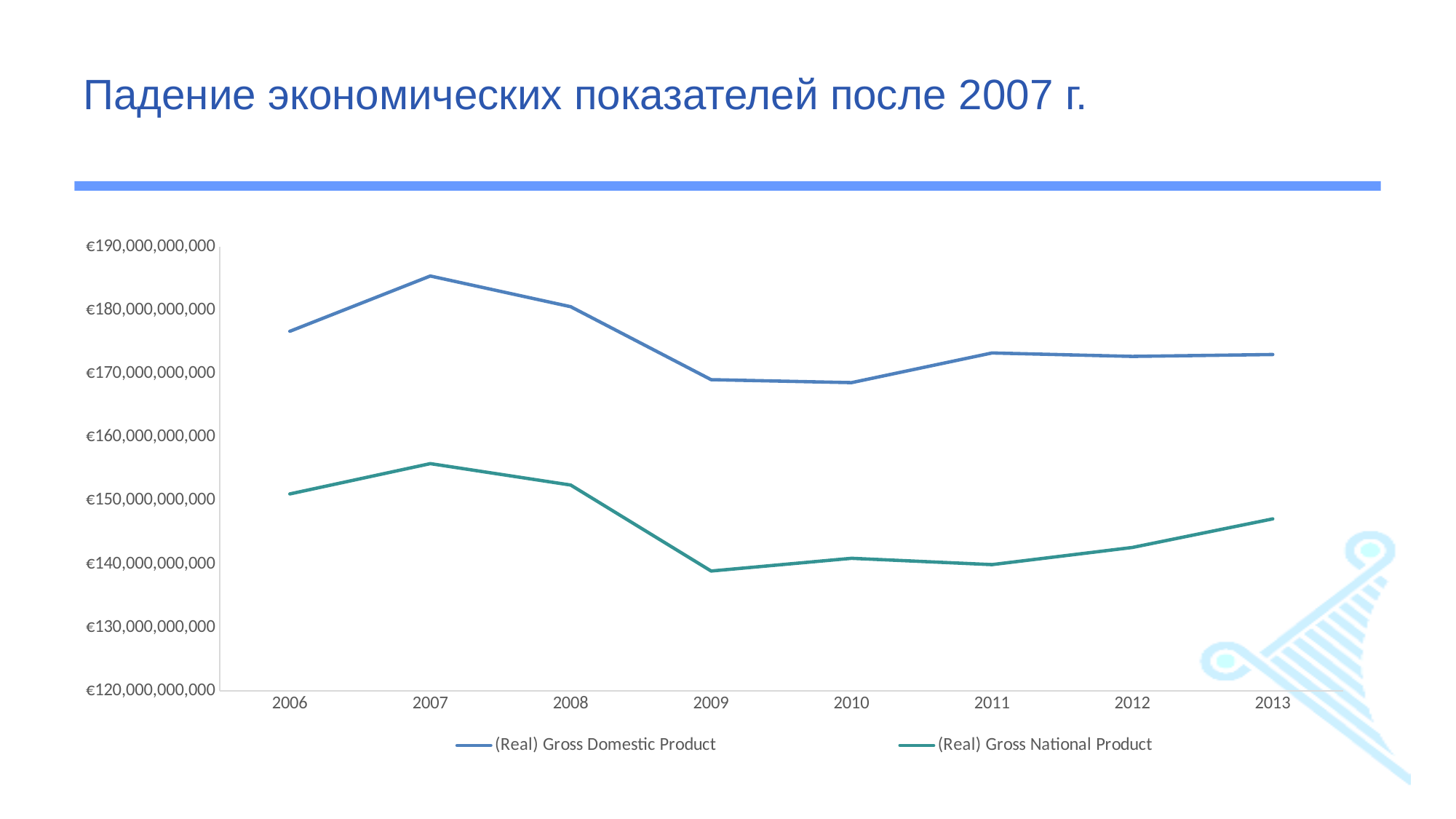
Is the value for (Real) Gross Domestic Product in 2007 greater or less than €180,000,000,000? greater Is the value for (Real) Gross Domestic Product in 2009 greater or less than €170,000,000,000? less What is the title of the slide? Падение экономических показателей после 2007 г. What kind of chart is shown on the slide? line chart In which year does (Real) Gross Domestic Product reach its highest value? 2007 Does (Real) Gross Domestic Product rise or fall from 2007 to 2009? fall Is the value for (Real) Gross National Product in 2009 greater or less than €140,000,000,000? less Which series has the larger value in 2010, (Real) Gross Domestic Product or (Real) Gross National Product? (Real) Gross Domestic Product How many series does the legend list? 2 In which year does (Real) Gross National Product reach its highest value? 2007 How many years are plotted along the x axis? 8